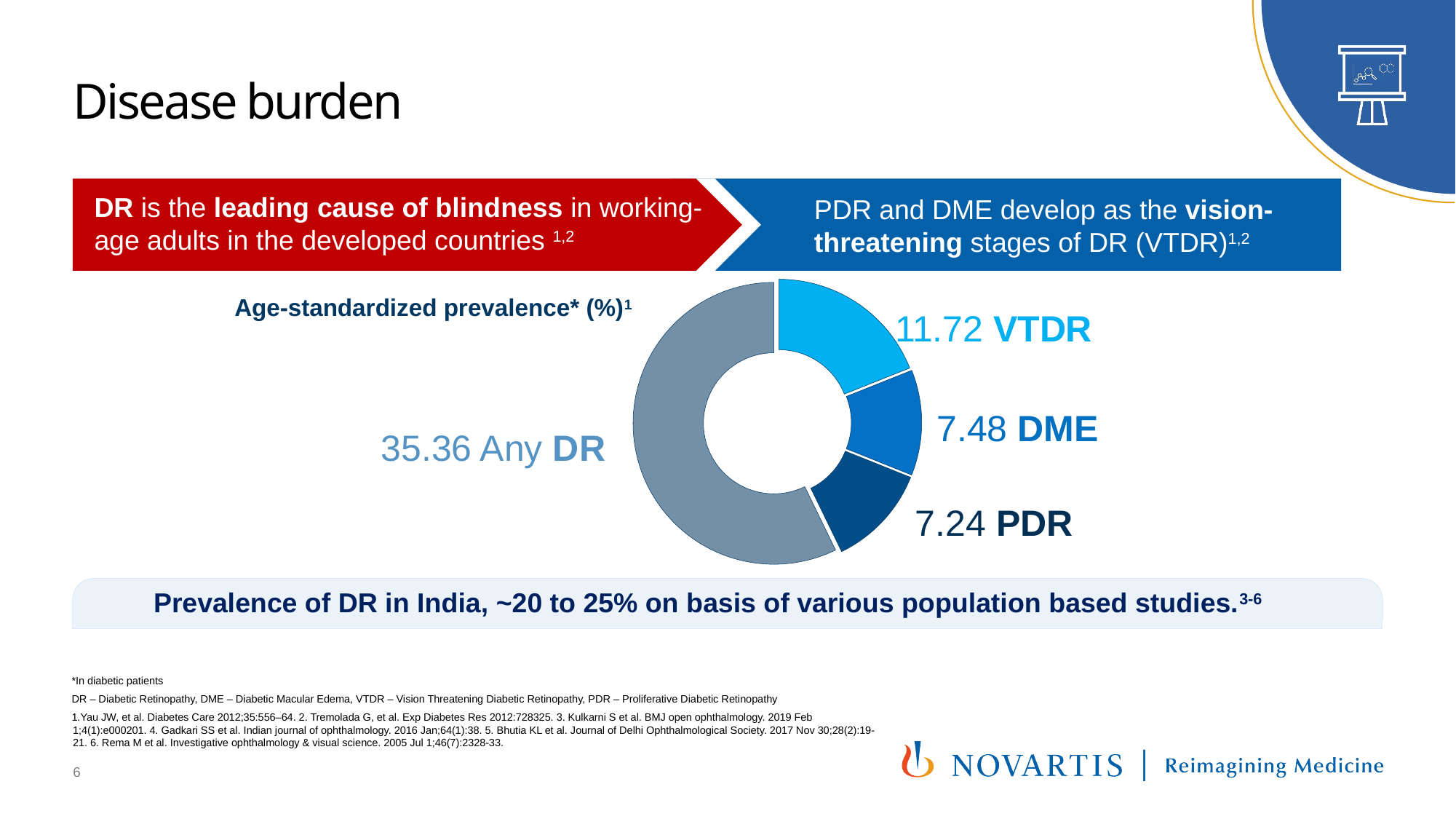
Which segment of the chart has the lowest value? PDR Which is larger, the value for DME or the value for PDR? DME What is the age-standardized prevalence value for Any DR? 35.36 What is the difference between the Any DR value and the VTDR value? 23.64 What is the title of the chart? Age-standardized prevalence* (%) What is the age-standardized prevalence value for VTDR? 11.72 How many segments does the donut chart have? 4 What is the difference between the VTDR value and the DME value? 4.24 What kind of chart is shown on the slide? Donut (pie) chart What is the age-standardized prevalence value for PDR? 7.24 Which segment of the chart has the highest value? Any DR What is the age-standardized prevalence value for DME? 7.48